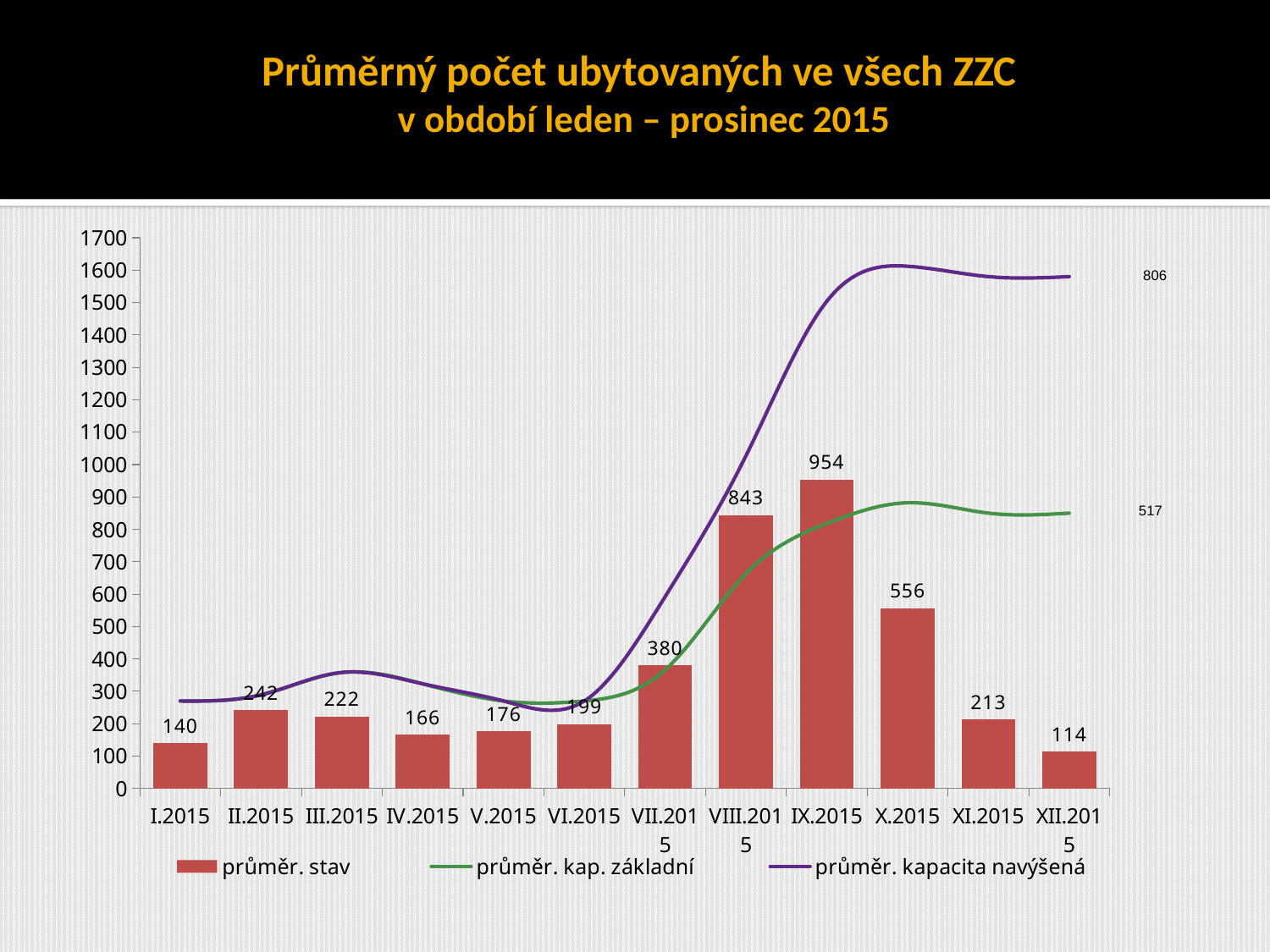
Which month has the lowest průměr. stav? XII.2015 Which month has the highest průměr. stav? IX.2015 How many series does the legend list? 3 How many months are shown on the x axis? 12 What is the value of průměr. stav for IX.2015? 954 What is the value of průměr. stav for I.2015? 140 Is the value of průměr. kap. základní for XII.2015 greater or less than 900? less What is the value of průměr. stav for VII.2015? 380 Which is larger, the průměr. stav for II.2015 or for III.2015? II.2015 Is the value of průměr. kapacita navýšená for X.2015 greater or less than 1500? greater Which series is drawn as bars? průměr. stav What is the difference between the průměr. stav values for IX.2015 and VIII.2015? 111